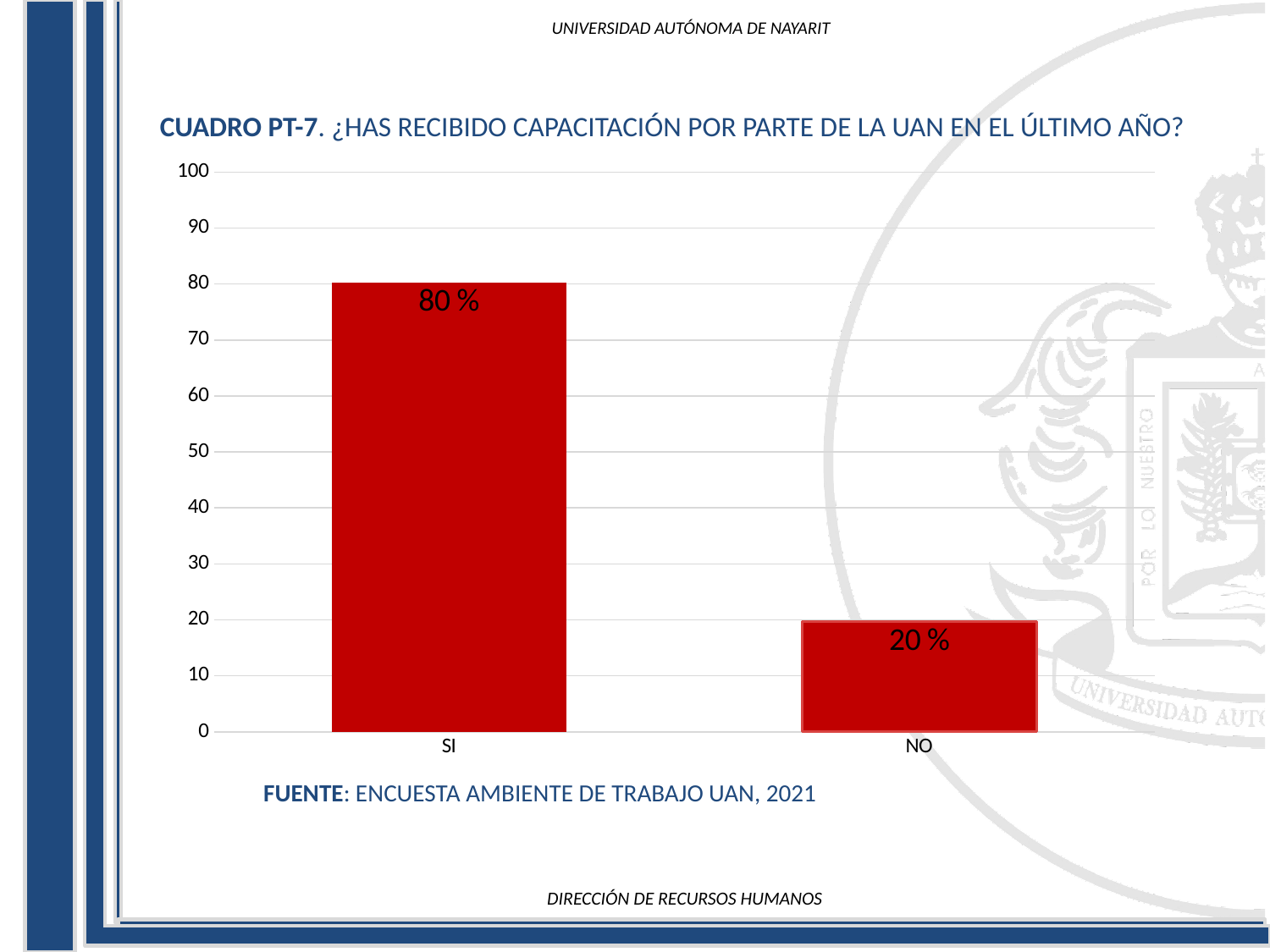
Which category has the highest value? SI Is the value for SI greater or less than 70? greater How many categories are shown on the x axis? 2 What kind of chart is shown on the slide? bar chart Is the value for NO greater or less than 30? less What colour are the bars in the chart? red What is the difference between the values for SI and NO? 60 % What is the title of the chart? CUADRO PT-7. ¿HAS RECIBIDO CAPACITACIÓN POR PARTE DE LA UAN EN EL ÚLTIMO AÑO? Which category has the lowest value? NO Which is larger, the value for SI or the value for NO? SI What is the value for SI? 80 % What is the value for NO? 20 %